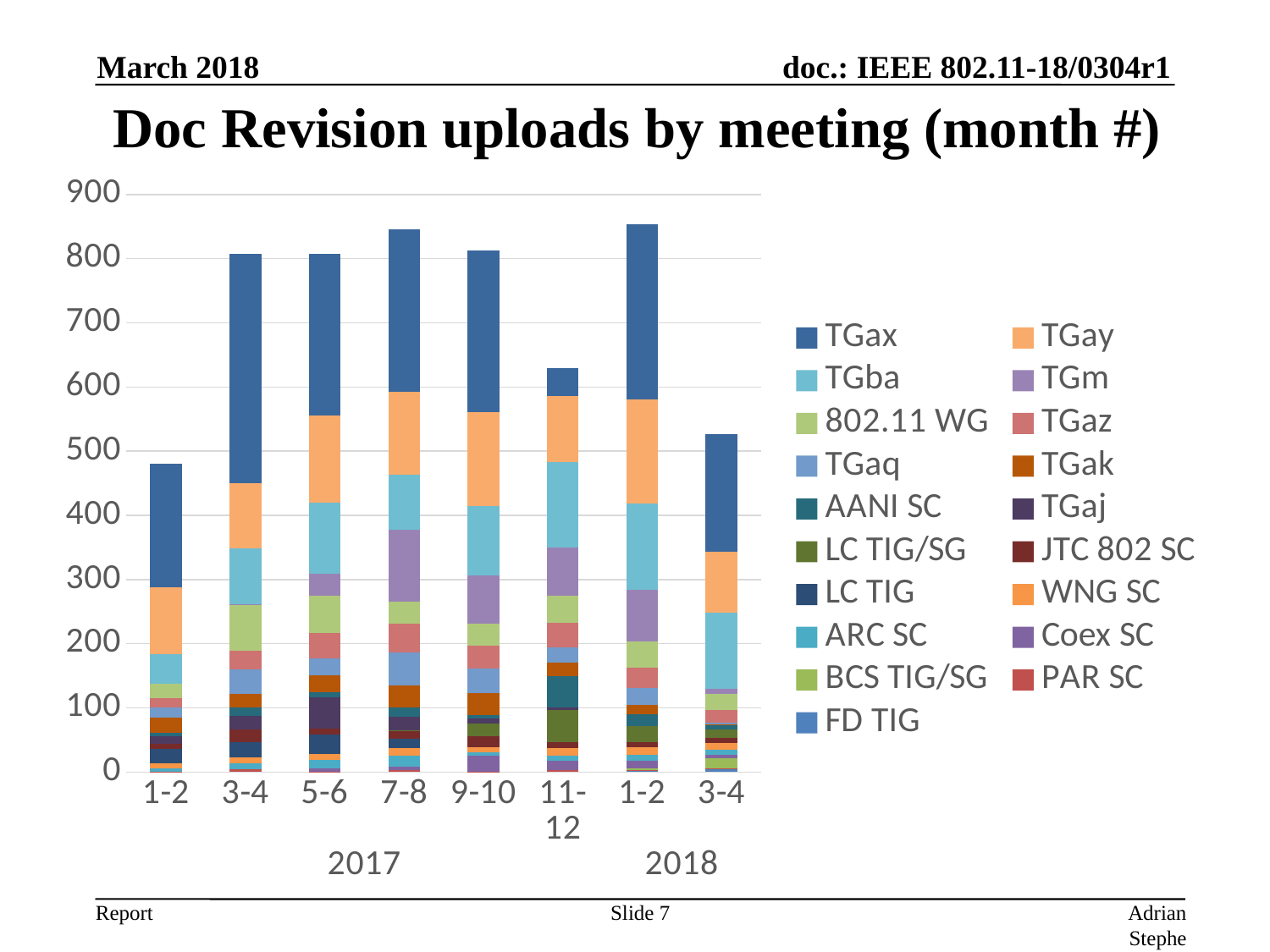
Is the total for the 2017 3-4 meeting greater or less than 800? greater What is the title of the chart? Doc Revision uploads by meeting (month #) Is the total for the 2017 11-12 meeting greater or less than 700? less How many series does the legend list? 19 Which series is listed first in the legend? TGax Which has a larger total, the 2017 3-4 meeting or the 2017 11-12 meeting? 2017 3-4 Is the total for the 2018 3-4 meeting greater or less than 600? less What kind of chart is shown on the slide? stacked bar chart How many bars (meetings) are plotted in the chart? 8 Which meeting has the lowest total bar? 2017 1-2